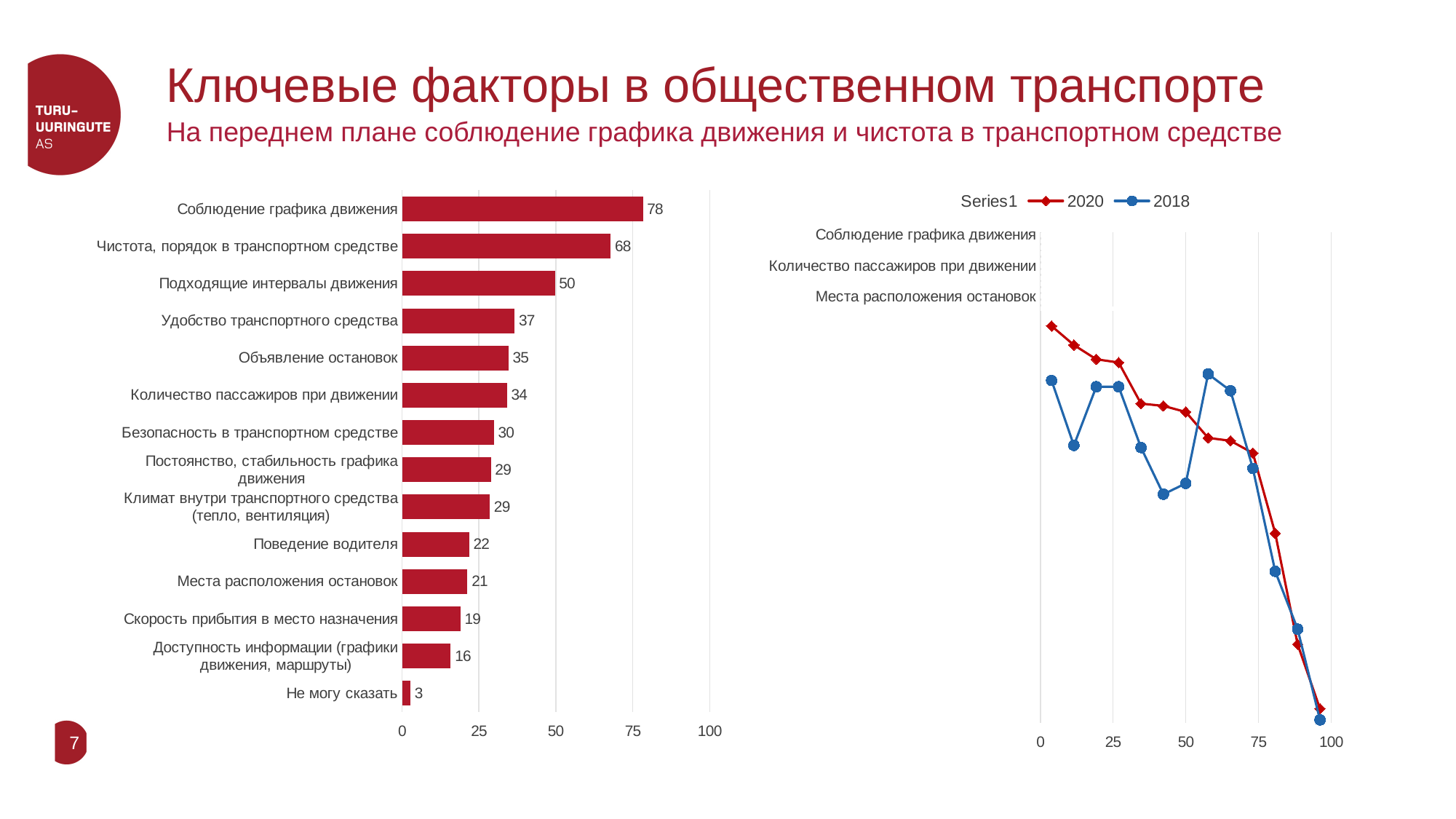
In the bar chart on the left, what is the value for Скорость прибытия в место назначения? 19 In the bar chart on the left, which category has the highest value? Соблюдение графика движения In the bar chart on the left, which is larger: the value for Удобство транспортного средства or the value for Объявление остановок? Удобство транспортного средства How many categories are shown in the bar chart on the left? 14 How many series does the legend of the chart on the right list? 3 In the bar chart on the left, is the value for Подходящие интервалы движения greater or less than 25? greater In the bar chart on the left, what is the value for Поведение водителя? 22 What kind of chart is the chart on the left of the slide? bar chart In the bar chart on the left, what is the value for Чистота, порядок в транспортном средстве? 68 In the bar chart on the left, which category has the lowest value? Не могу сказать In the bar chart on the left, what is the value for Соблюдение графика движения? 78 In the bar chart on the left, what is the difference between the values for Соблюдение графика движения and Чистота, порядок в транспортном средстве? 10